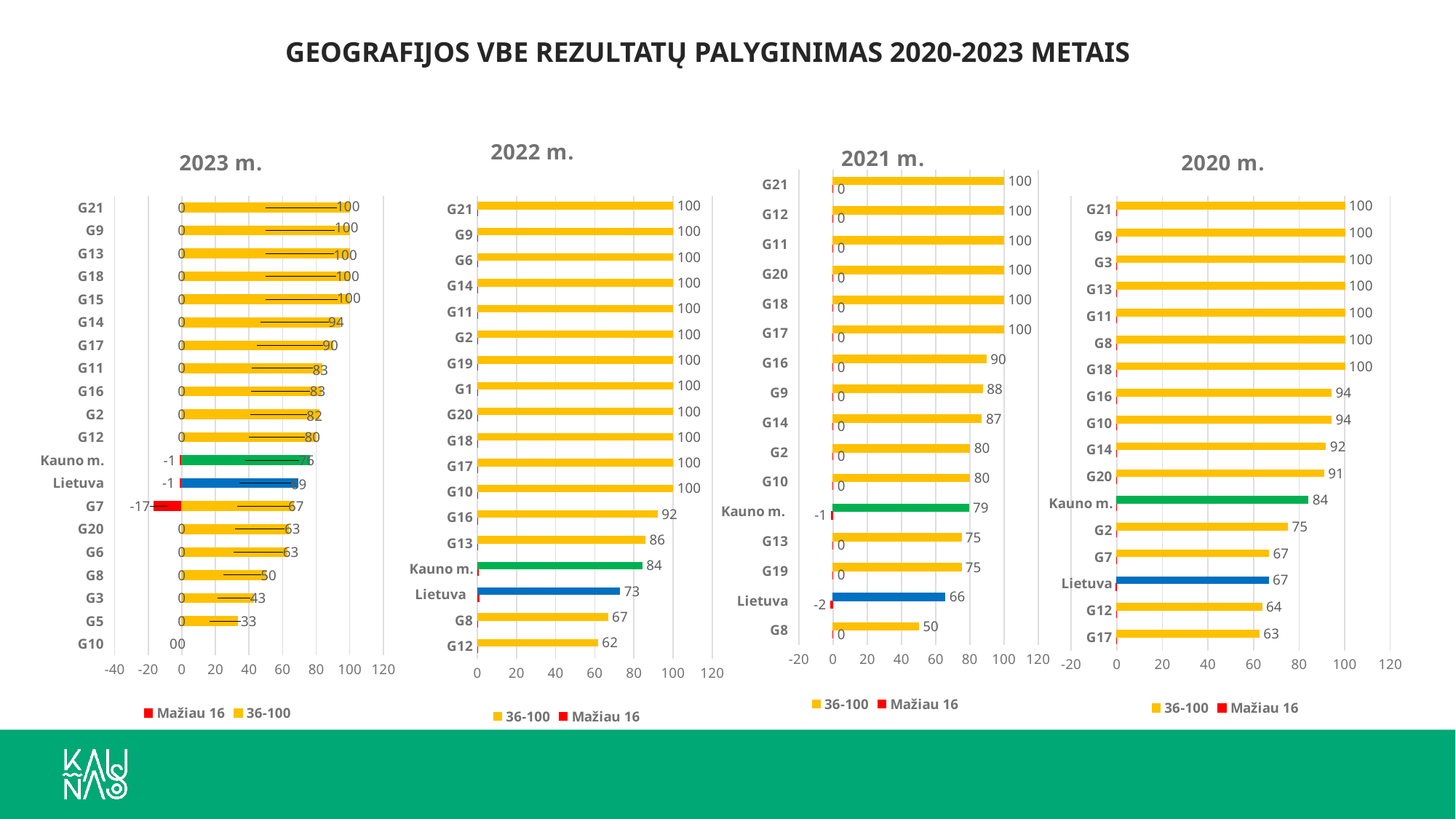
How many categories are shown in the 2022 m. chart? 18 How many series does the legend of the 2020 m. chart list? 2 In the 2020 m. chart, what is the 36-100 value for G17? 63 In the 2023 m. chart, what is the Mažiau 16 value for G7? -17 In the 2022 m. chart, what is the 36-100 value for Lietuva? 73 In the 2020 m. chart, which is larger, the 36-100 value for Kauno m. or for Lietuva? Kauno m. In the 2021 m. chart, what is the 36-100 value for Kauno m.? 79 What type of chart is the 2023 m. chart? Bar chart In the 2023 m. chart, what is the 36-100 value for G5? 33 In the 2021 m. chart, what is the difference between the 36-100 values for G16 and G8? 40 In the 2021 m. chart, what is the Mažiau 16 value for Lietuva? -2 In the 2022 m. chart, which category has the lowest 36-100 value? G12